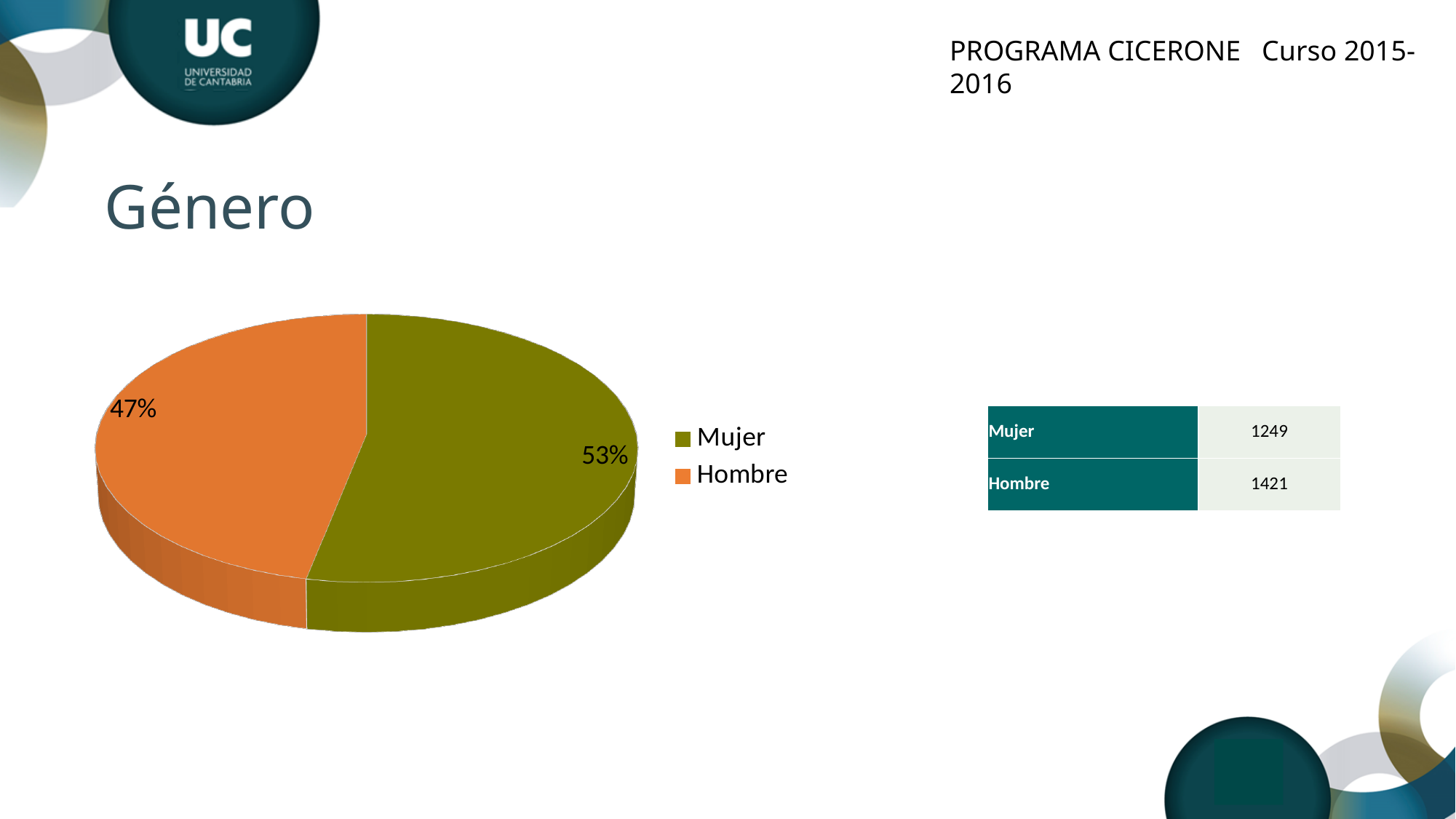
What share of the pie does the Hombre slice represent? 47% Which slice of the pie chart is the smallest? Hombre How many entries does the legend of the pie chart list? 2 By how many percentage points does the Mujer slice exceed the Hombre slice in the pie chart? 6 What percentage of the pie chart is labelled for Mujer? 53% What colour is the Hombre slice in the pie chart? orange What kind of chart is shown on the slide? pie chart What percentage of the pie chart is labelled for Hombre? 47% What is the title of the slide containing the pie chart? Género How many slices does the pie chart have? 2 In the pie chart, which is larger, the Mujer slice or the Hombre slice? Mujer Which slice of the pie chart is the largest? Mujer